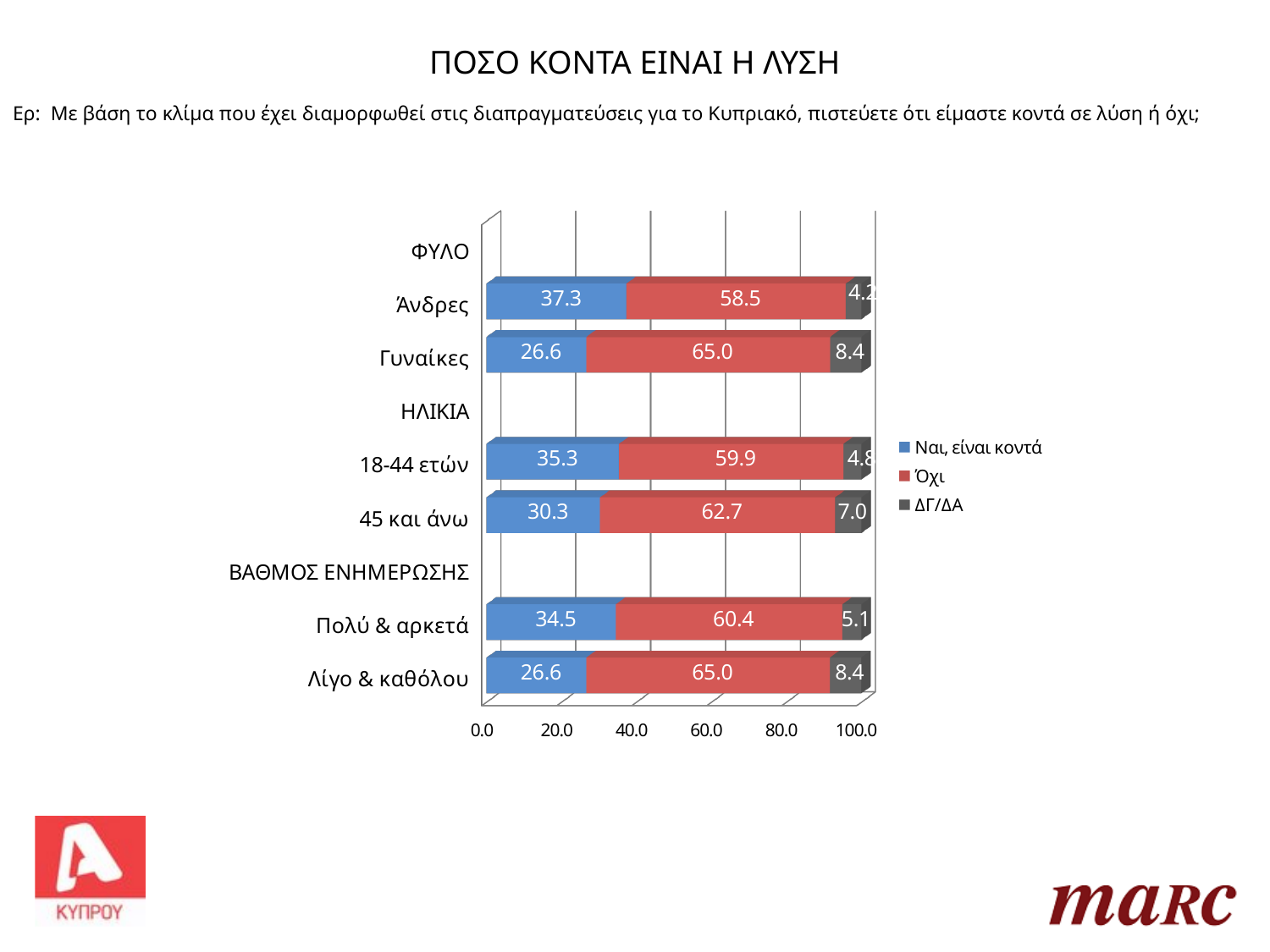
What kind of chart is shown on the slide? Stacked bar chart What is the value of "Όχι" for 18-44 ετών? 59.9 What is the value of "Ναι, είναι κοντά" for Άνδρες? 37.3 What is the value of "Ναι, είναι κοντά" for Πολύ & αρκετά? 34.5 How many series does the legend list? 3 What is the value of "Όχι" for Γυναίκες? 65.0 What is the value of "ΔΓ/ΔΑ" for 45 και άνω? 7.0 Which category has the lowest value for "ΔΓ/ΔΑ"? Άνδρες What is the total of the stacked bar for Λίγο & καθόλου? 100.0 What is the difference between the "Όχι" values for Γυναίκες and Άνδρες? 6.5 Which category has the highest value for "Ναι, είναι κοντά"? Άνδρες Which is larger: the "Ναι, είναι κοντά" value for 18-44 ετών or for 45 και άνω? 18-44 ετών